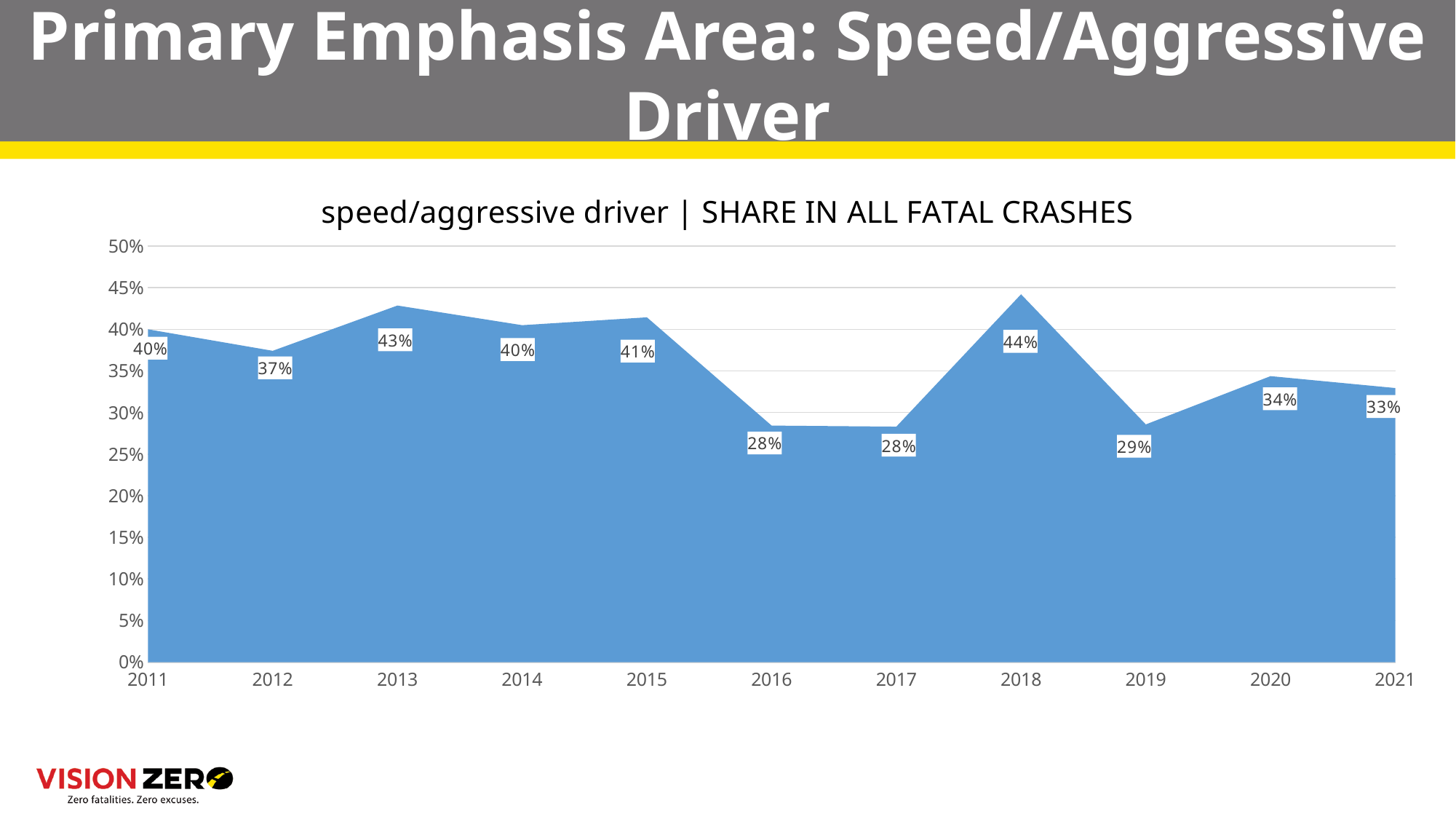
What kind of chart is shown on the slide? area chart What is the share of speed/aggressive driver in all fatal crashes in 2018? 44% What is the title of the chart? speed/aggressive driver | SHARE IN ALL FATAL CRASHES What is the difference between the share in 2018 and the share in 2019? 15% Does the share rise or fall from 2019 to 2020? rise Which year has a larger share, 2013 or 2015? 2013 Is the value for 2016 greater or less than 30%? less What is the lowest share value shown on the chart? 28% How many years are shown on the x axis of the chart? 11 Which year has the highest share of speed/aggressive driver in all fatal crashes? 2018 What is the share of speed/aggressive driver in all fatal crashes in 2012? 37% What is the share of speed/aggressive driver in all fatal crashes in 2021? 33%